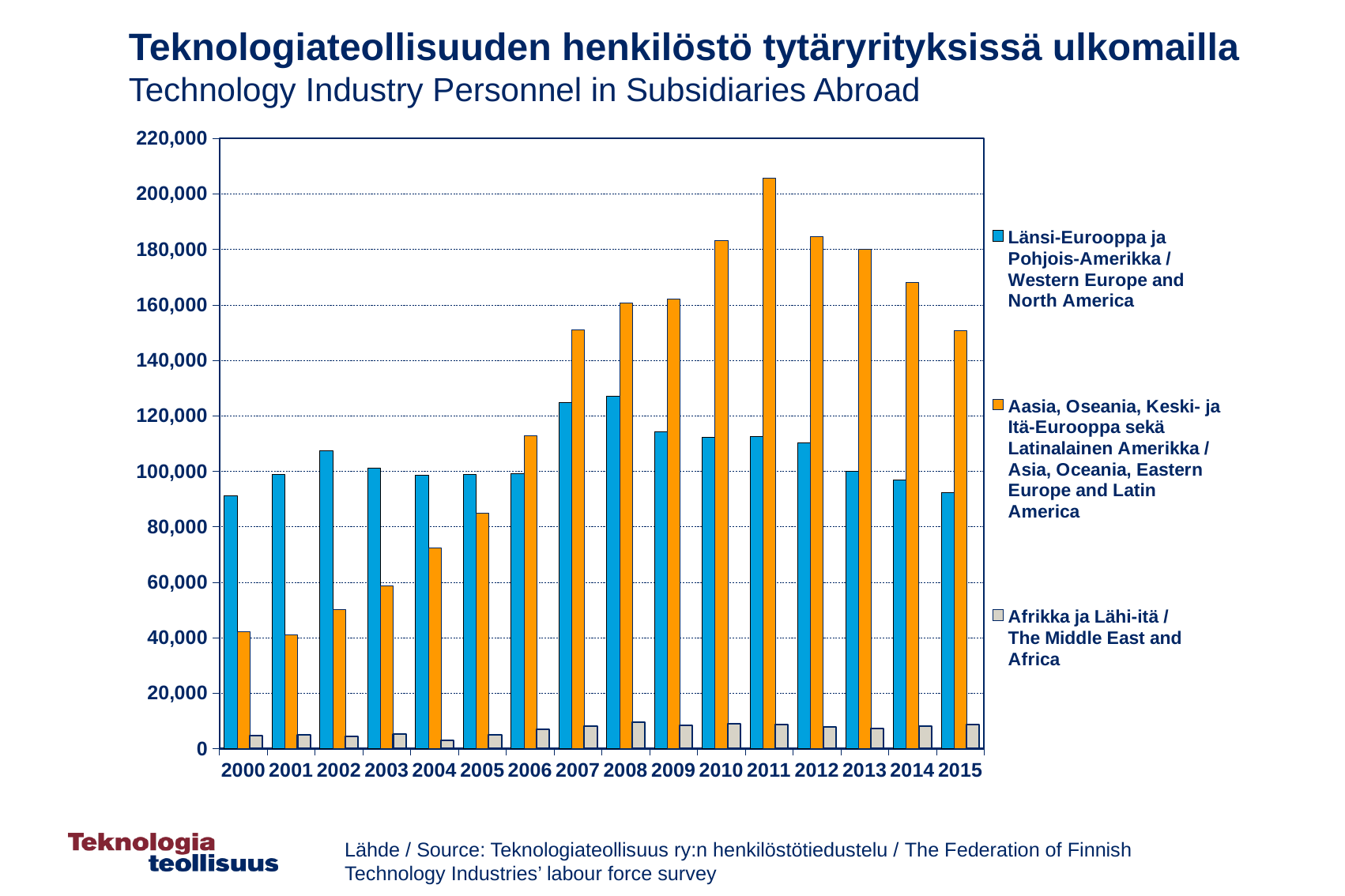
What is the English title of the chart? Technology Industry Personnel in Subsidiaries Abroad Is the value for The Middle East and Africa in 2008 greater or less than 20,000? less What kind of chart is shown on the slide? bar chart How many years are shown on the x axis? 16 In 2005, which series has the larger value: Western Europe and North America or Asia, Oceania, Eastern Europe and Latin America? Western Europe and North America Do the values for Asia, Oceania, Eastern Europe and Latin America rise or fall from 2000 to 2011? rise Is the value for Western Europe and North America in 2007 greater or less than 120,000? greater In 2015, which series has the larger value: Western Europe and North America or Asia, Oceania, Eastern Europe and Latin America? Asia, Oceania, Eastern Europe and Latin America Is the value for Asia, Oceania, Eastern Europe and Latin America in 2011 greater or less than 200,000? greater How many series does the legend list? 3 In which year is the value for Asia, Oceania, Eastern Europe and Latin America highest? 2011